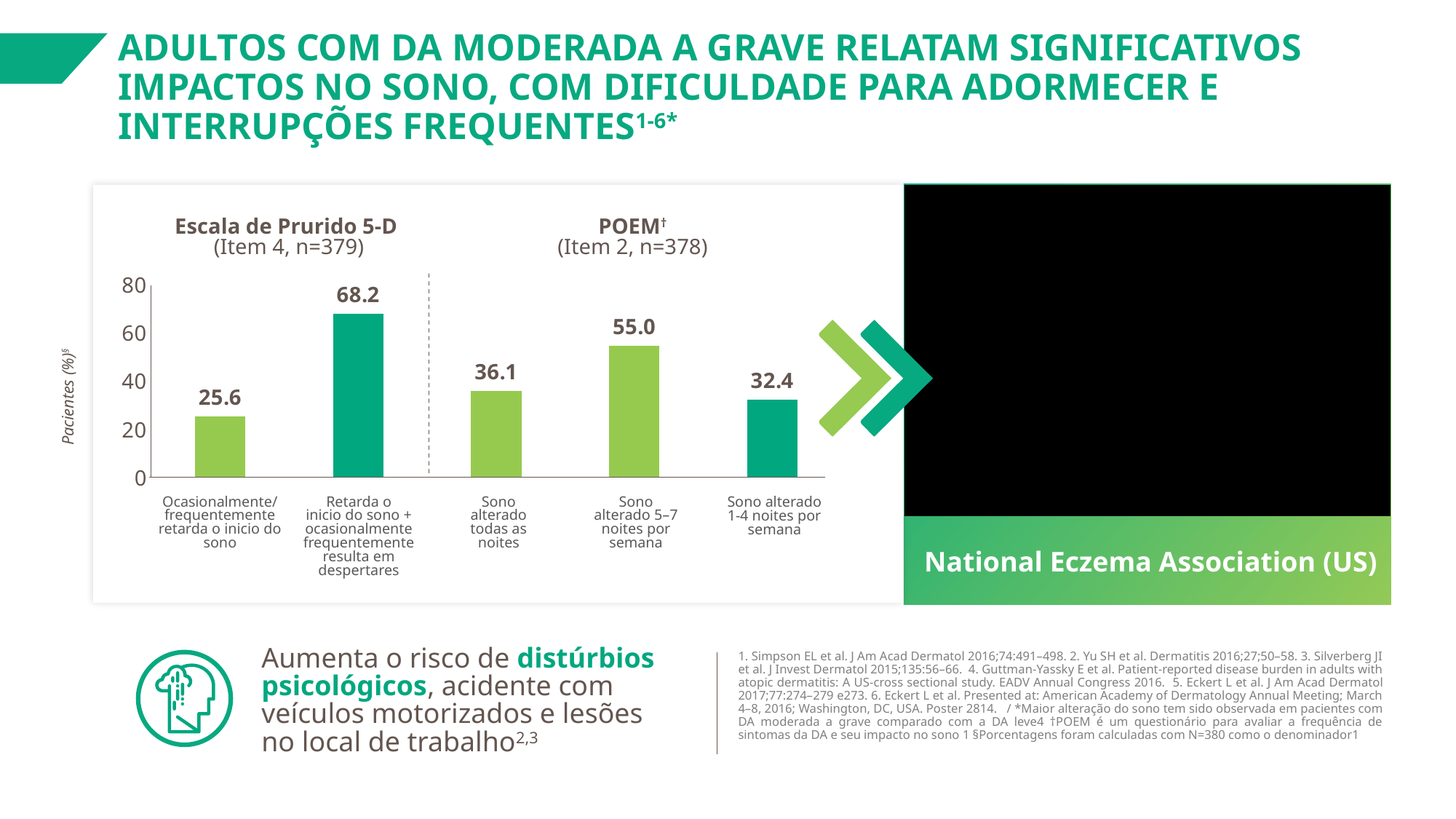
What is the value for 'Sono alterado todas as noites'? 36.1 What is the difference between 'Sono alterado 5–7 noites por semana' and 'Sono alterado 1-4 noites por semana'? 22.6 What is the value for 'Ocasionalmente/frequentemente retarda o inicio do sono'? 25.6 Which is larger: the value for 'Sono alterado todas as noites' or 'Sono alterado 1-4 noites por semana'? Sono alterado todas as noites What type of chart is shown on the slide? bar chart Which category has the lowest value in the chart? Ocasionalmente/frequentemente retarda o inicio do sono Which category has the highest value in the chart? Retarda o inicio do sono + ocasionalmente frequentemente resulta em despertares What is the value for 'Sono alterado 1-4 noites por semana'? 32.4 How many bars are plotted in the chart? 5 What is the difference between the two bars in the Escala de Prurido 5-D group (68.2 and 25.6)? 42.6 What is the value for 'Sono alterado 5–7 noites por semana'? 55.0 What is the label of the y axis of the chart? Pacientes (%)